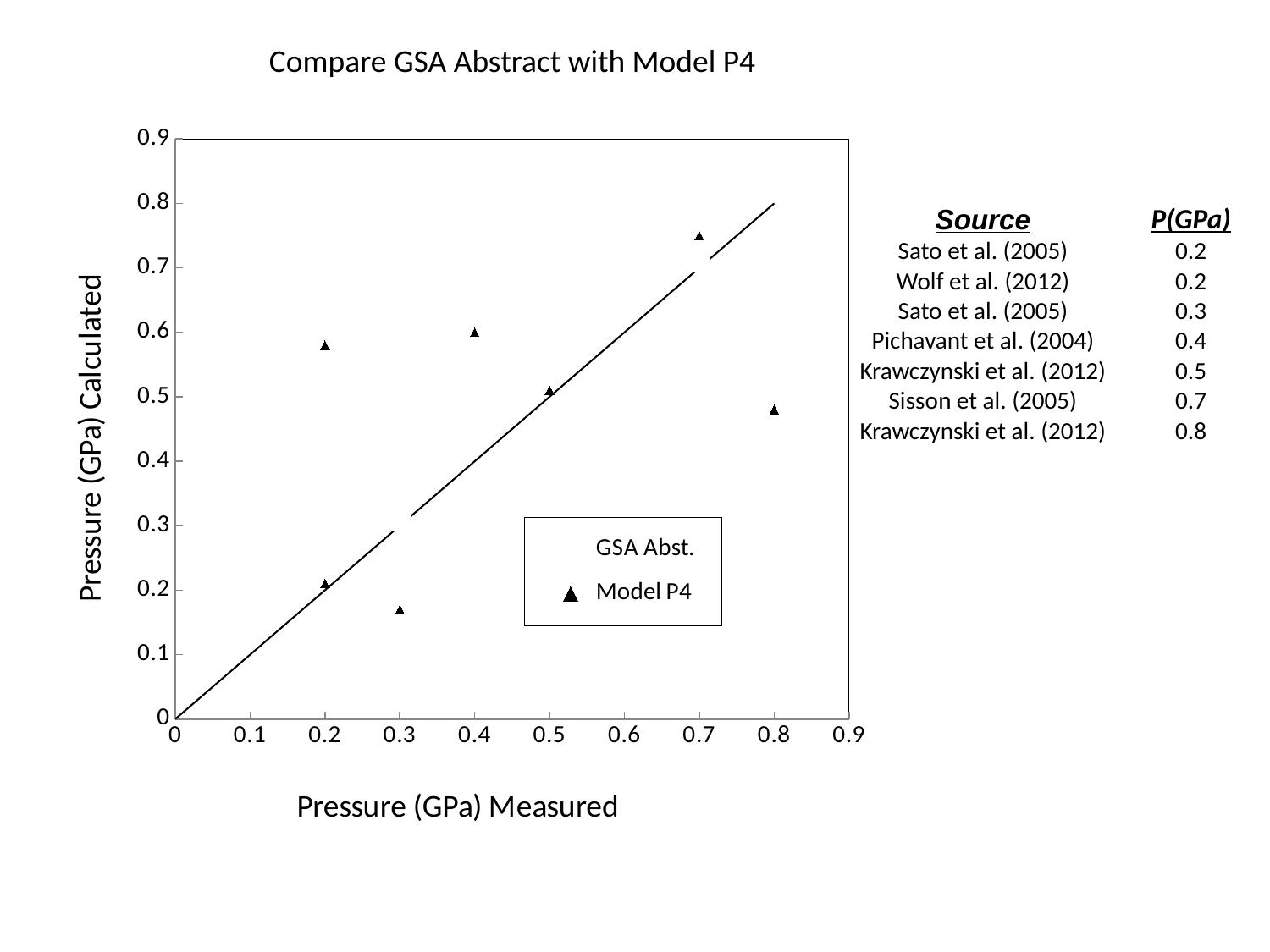
How many Model P4 triangle points are plotted on the chart? 7 Which Model P4 point has the highest calculated pressure, by its measured pressure? 0.7 What is the title of the chart? Compare GSA Abstract with Model P4 Is the calculated pressure for the Model P4 point at measured pressure 0.8 greater or less than 0.4? greater What is the label of the vertical axis? Pressure (GPa) Calculated Which has the higher calculated pressure: the Model P4 point at measured pressure 0.7 or the one at measured pressure 0.4? 0.7 Is the calculated pressure for the Model P4 point at measured pressure 0.5 greater or less than 0.4? greater How many series does the chart legend list? 2 What kind of chart is shown on the slide? scatter chart Which has the higher calculated pressure: the upper Model P4 point at measured pressure 0.2 or the point at measured pressure 0.8? the point at 0.2 Is the calculated pressure for the Model P4 point at measured pressure 0.3 greater or less than 0.2? less